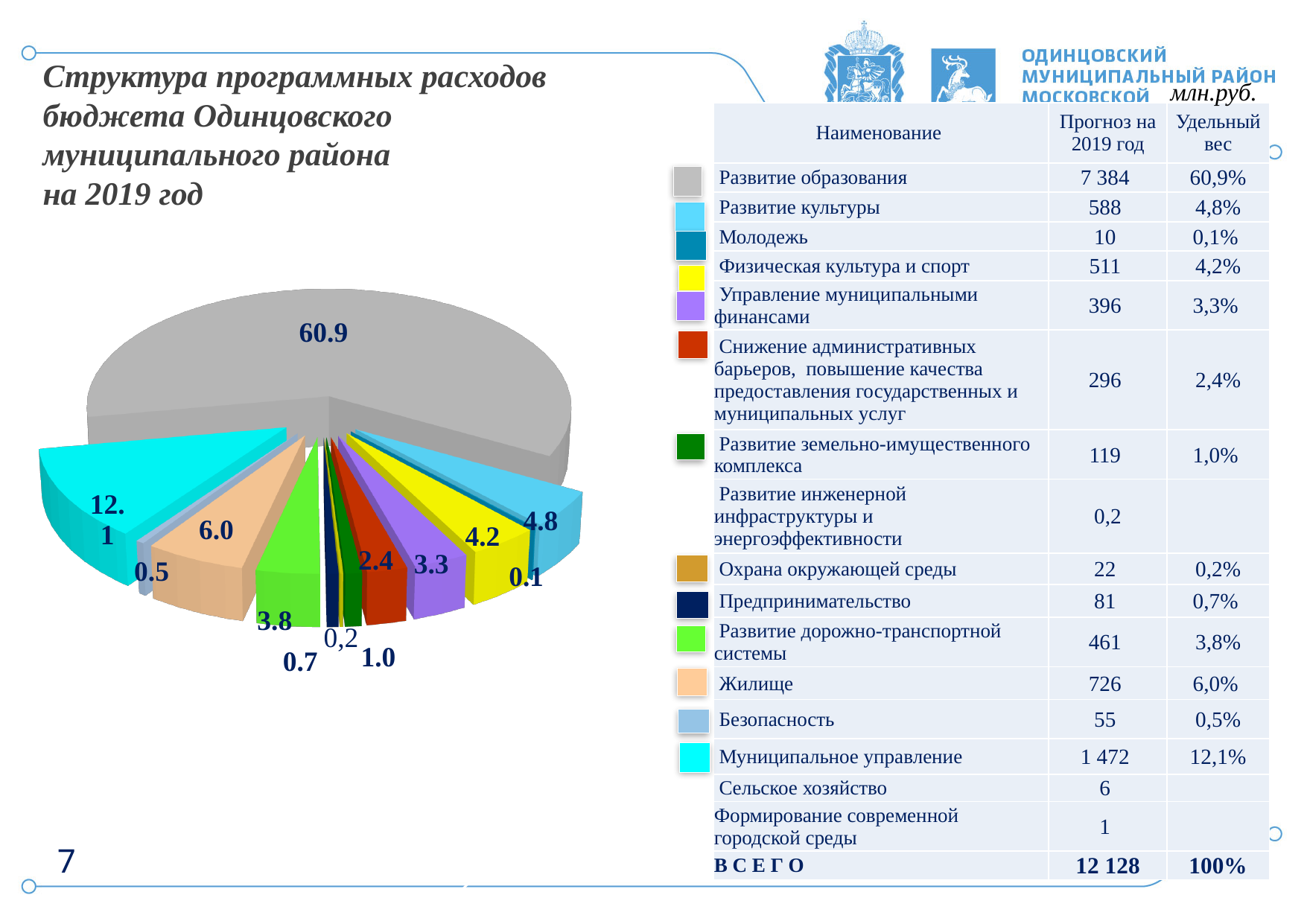
Which slice of the pie chart is the largest? Развитие образования (60.9) How many data labels are shown on the pie chart? 13 What value is labelled on the yellow slice (Физическая культура и спорт)? 4.2 What kind of chart is shown on the slide? pie chart What value is labelled on the peach slice for Жилище? 6.0 What value is labelled on the red slice (Снижение административных барьеров)? 2.4 What value is labelled on the cyan slice for Муниципальное управление? 12.1 What value is labelled on the purple slice (Управление муниципальными финансами)? 3.3 Which is larger in the pie chart: the slice for Жилище (peach) or the slice for Развитие культуры (light blue)? Жилище What is the difference between the labelled values of the grey slice (60.9) and the cyan slice (12.1)? 48.8 What is the smallest labelled value on the pie chart? 0.1 What value is labelled on the largest (grey) slice of the pie chart? 60.9